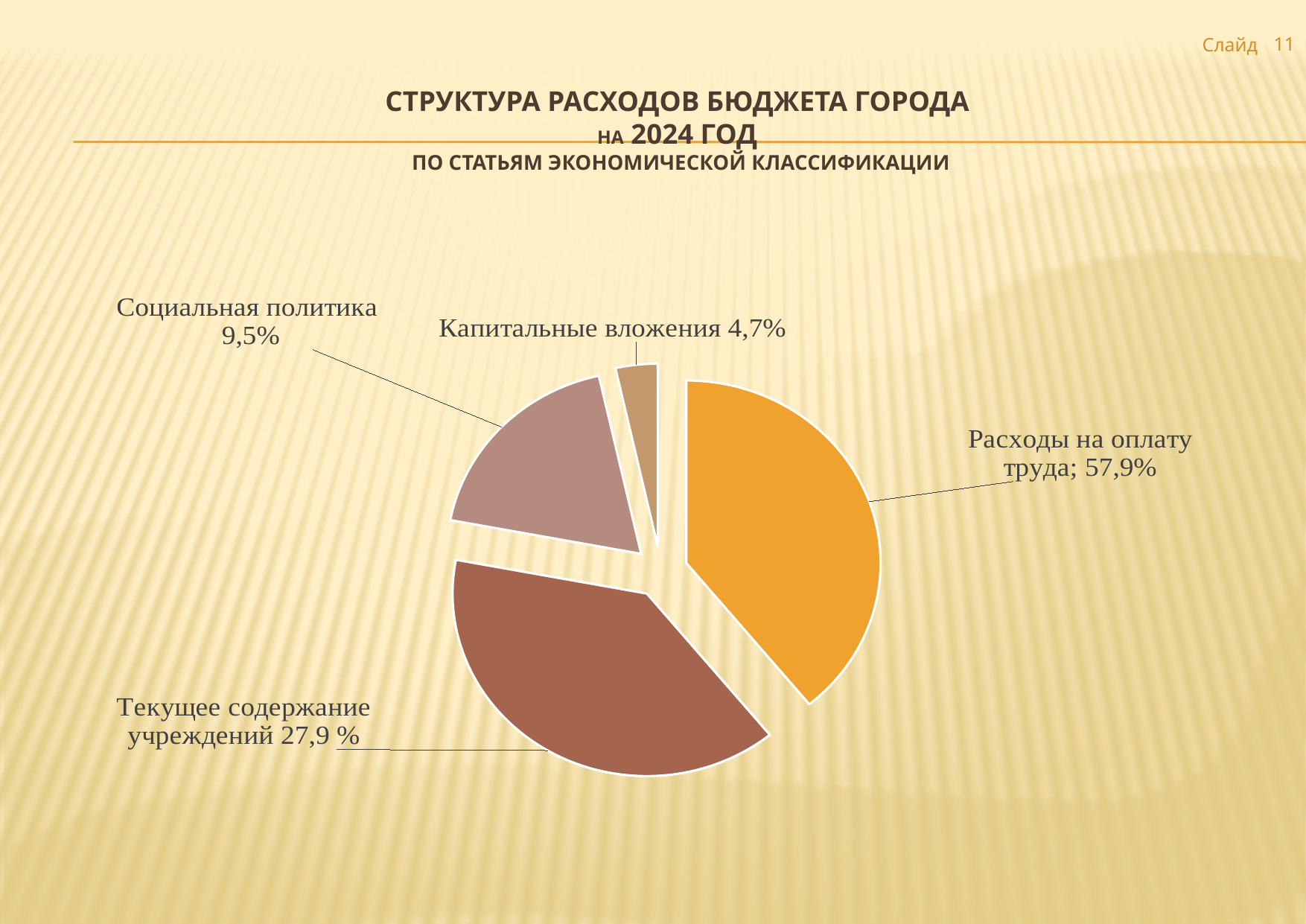
What is the difference in percentage points between "Социальная политика" and "Капитальные вложения"? 4,8 percentage points What share of the pie does "Расходы на оплату труда" have? 57,9% Which is larger: the share for "Социальная политика" or the share for "Капитальные вложения"? Социальная политика How many slices does the pie chart have? 4 What kind of chart is shown on the slide? Pie chart Which category has the smallest slice of the pie? Капитальные вложения What year does the chart title refer to? 2024 What share of the pie does "Капитальные вложения" have? 4,7% What share of the pie does "Текущее содержание учреждений" have? 27,9 % What is the difference in percentage points between "Расходы на оплату труда" and "Текущее содержание учреждений"? 30 percentage points Which category has the largest slice of the pie? Расходы на оплату труда